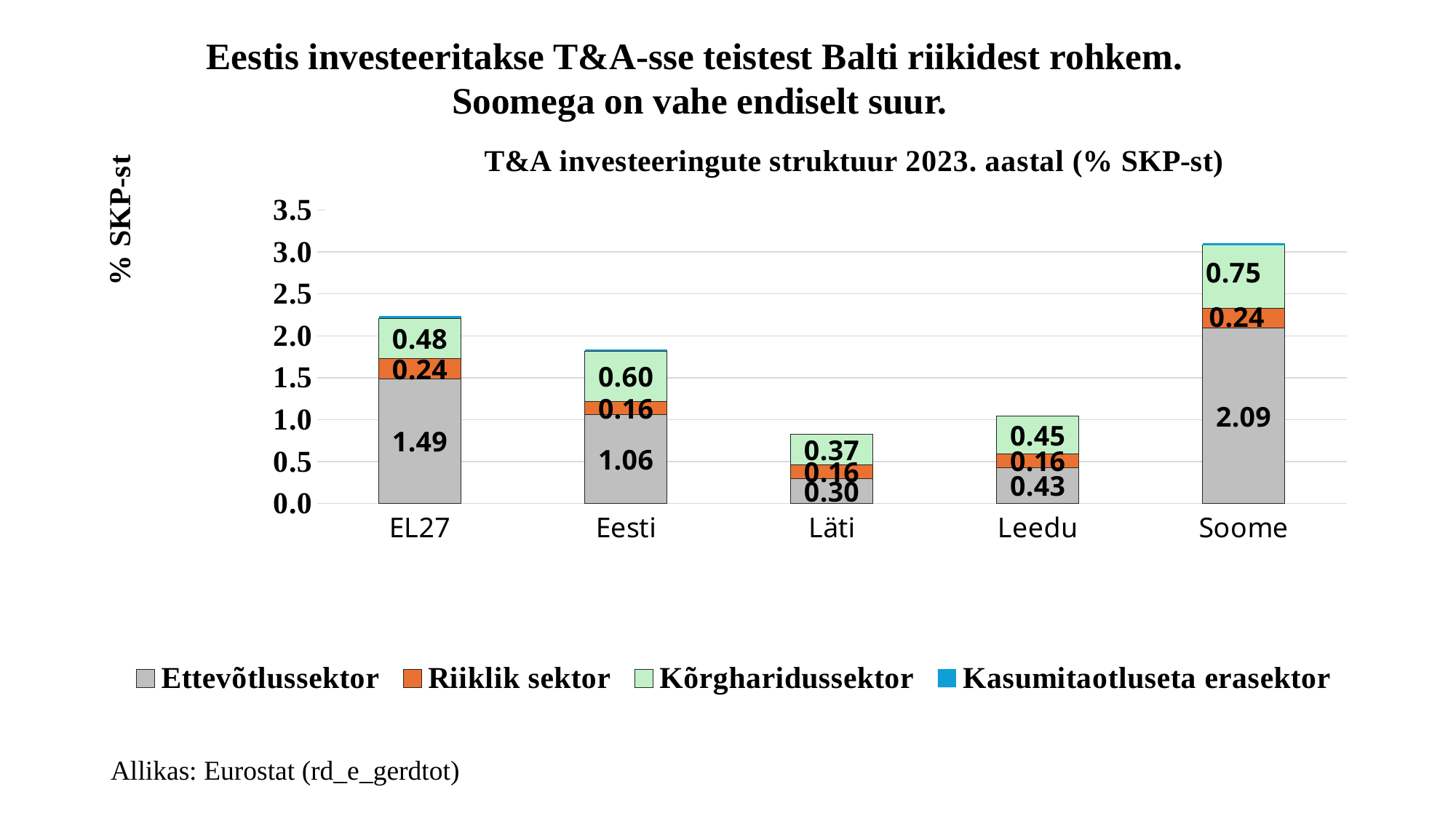
What kind of chart is shown on the slide? Stacked bar chart How many series does the legend list? 4 How many countries or regions are shown on the x axis? 5 What is the Ettevõtlussektor value for EL27? 1.49 What is the Ettevõtlussektor value for Soome? 2.09 Which is larger, the Kõrgharidussektor value for Eesti or for EL27? Eesti What is the Kõrgharidussektor value for Eesti? 0.60 Which country or region has the lowest Ettevõtlussektor value? Läti Is the total height of the Soome bar greater or less than 3.0? greater Which country or region has the highest Ettevõtlussektor value? Soome What is the difference between the Ettevõtlussektor values for Soome and Eesti? 1.03 What is the Riiklik sektor value for Läti? 0.16